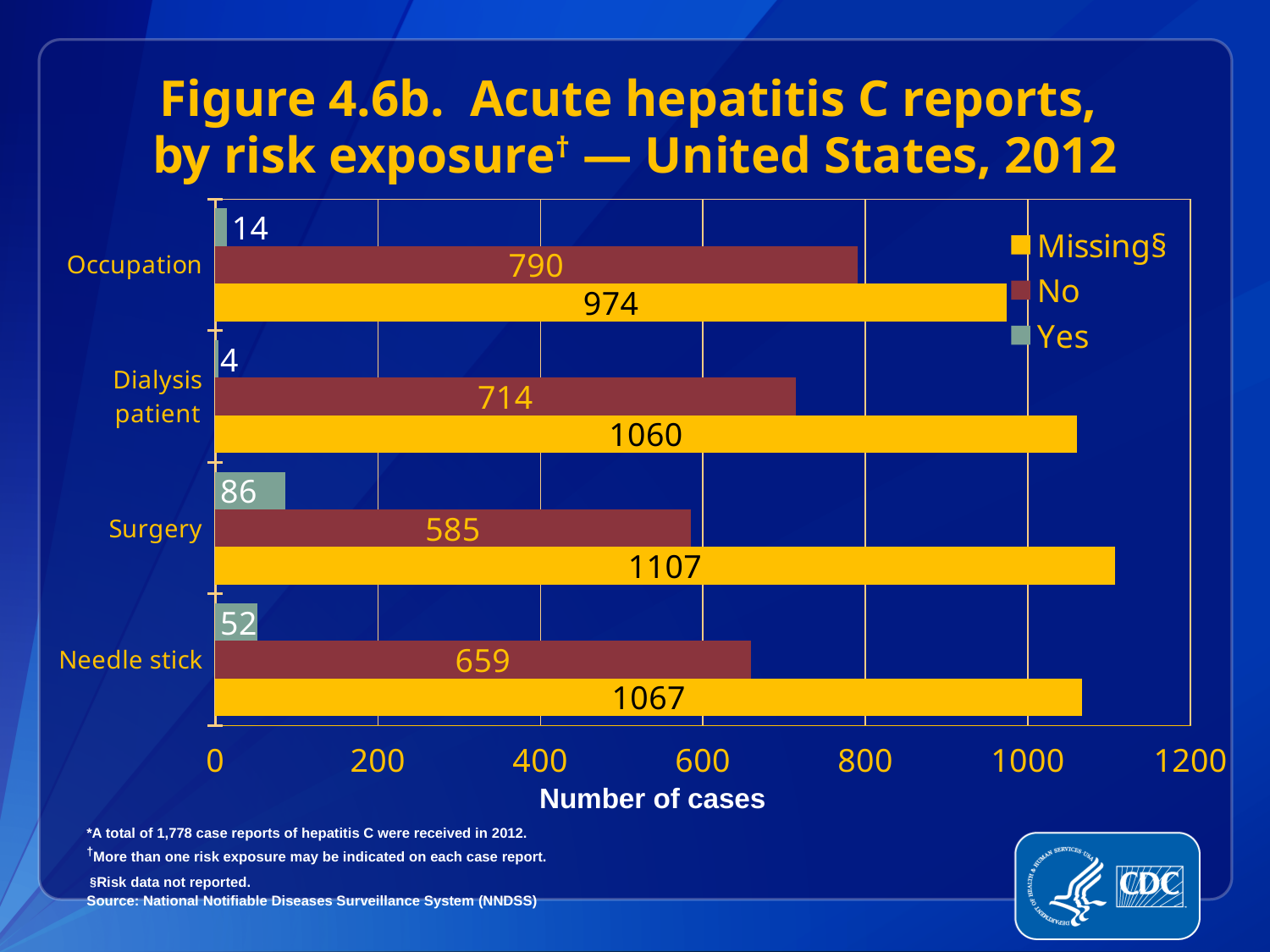
Which risk exposure category has the highest 'Missing' value? Surgery What is the number of cases with 'Yes' for Surgery? 86 What is the number of cases with 'No' for Needle stick? 659 What kind of chart is shown on the slide? bar chart How many risk exposure categories are shown on the chart? 4 What is the difference between the 'No' values for Occupation and Surgery? 205 Is the 'No' value for Dialysis patient greater or less than 800? less What is the label of the x axis? Number of cases What is the number of cases with 'Missing' for Dialysis patient? 1060 Which is larger, the 'Yes' value for Needle stick or the 'Yes' value for Occupation? Needle stick How many series does the legend list? 3 Which risk exposure category has the lowest 'Yes' value? Dialysis patient